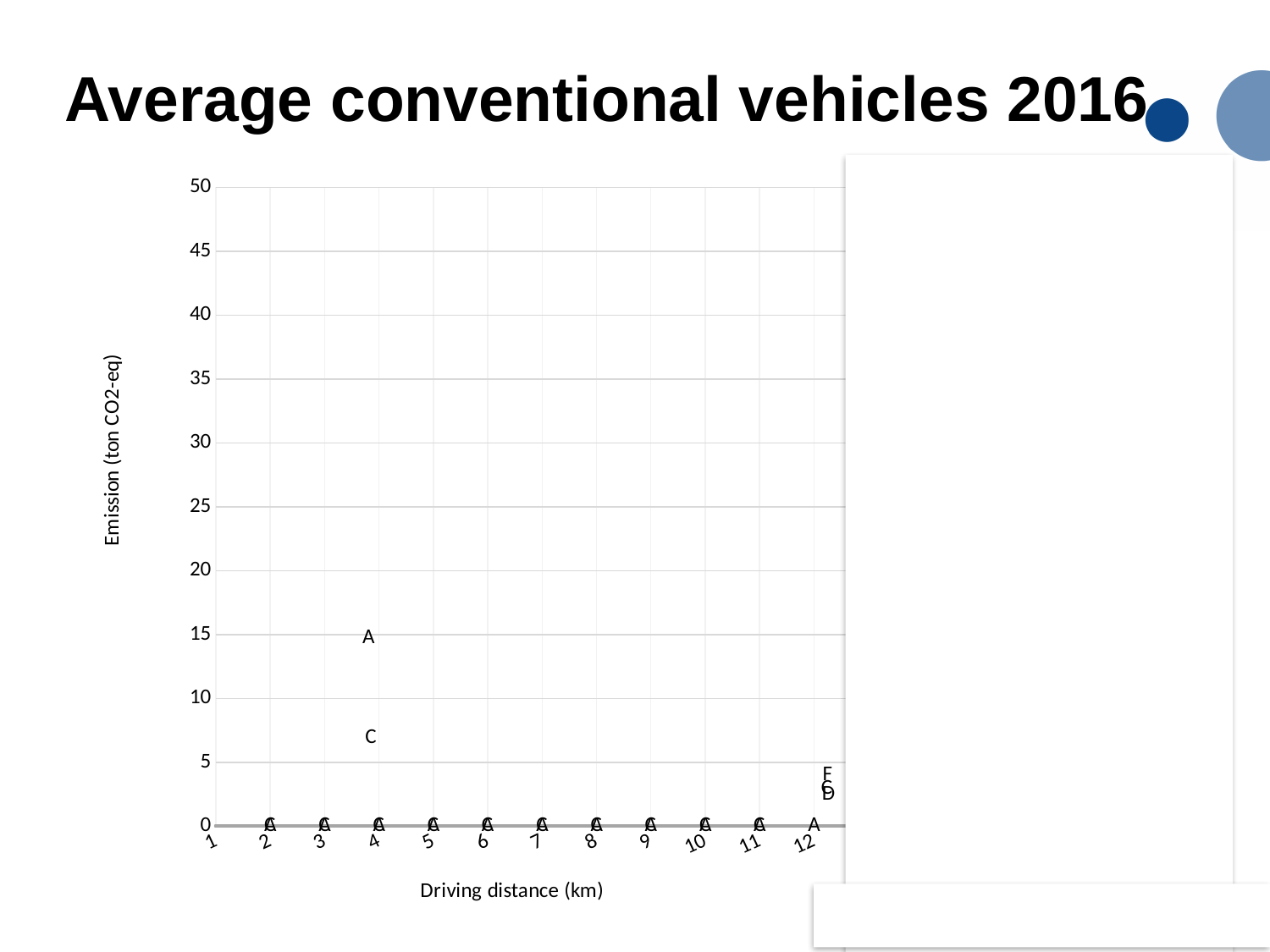
At driving distance 4, which is larger, the value labelled A or the value labelled C? A Is the value labelled C at driving distance 4 greater or less than 10? less What is the label of the vertical axis? Emission (ton CO2-eq) Is the value labelled C at driving distance 4 greater or less than 5? greater Is the value labelled A at driving distance 4 greater or less than 10? greater What is the highest value shown on the vertical axis? 50 Which driving distance has the highest plotted point on the chart? 4 What is the title of the chart? Average conventional vehicles 2016 How many driving distance categories are shown on the x axis? 12 At driving distance 12, which is larger, the value labelled F or the value labelled D? F